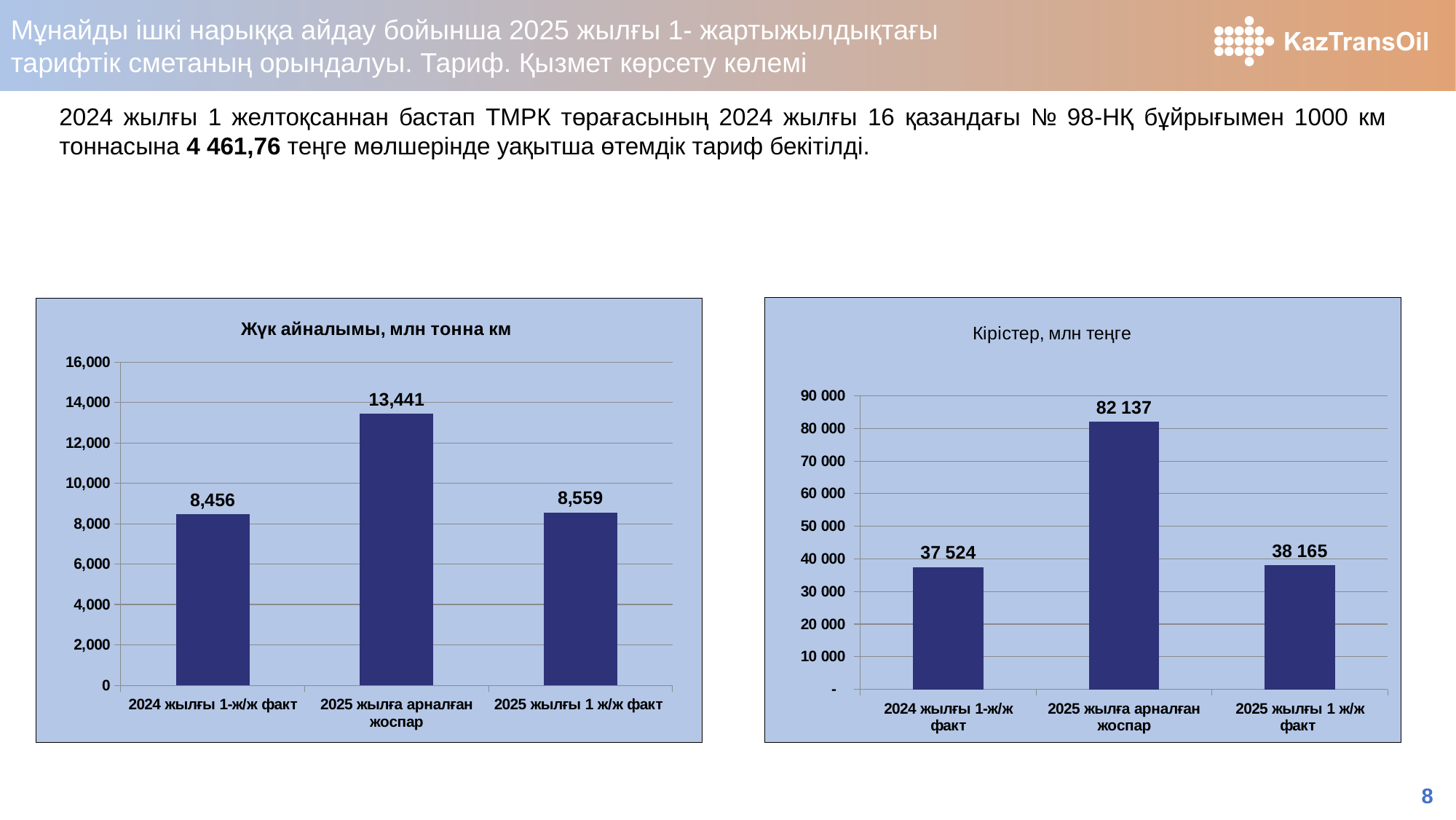
In the chart titled "Кірістер, млн теңге", is the value for "2025 жылға арналған жоспар" greater or less than 80 000? greater In the chart titled "Кірістер, млн теңге", what is the value for "2025 жылға арналған жоспар"? 82 137 What is the title of the chart on the left side of the slide? Жүк айналымы, млн тонна км In the chart titled "Жүк айналымы, млн тонна км", what is the value for "2025 жылға арналған жоспар"? 13,441 In the chart titled "Кірістер, млн теңге", what is the value for "2025 жылғы 1 ж/ж факт"? 38 165 What type of chart is the chart titled "Кірістер, млн теңге"? bar chart In the chart titled "Кірістер, млн теңге", which category has the highest value? 2025 жылға арналған жоспар In the chart titled "Кірістер, млн теңге", what is the difference between "2025 жылғы 1 ж/ж факт" and "2024 жылғы 1-ж/ж факт"? 641 In the chart titled "Жүк айналымы, млн тонна км", how many bars are plotted? 3 In the chart titled "Жүк айналымы, млн тонна км", which category has the lowest value? 2024 жылғы 1-ж/ж факт In the chart titled "Жүк айналымы, млн тонна км", what is the difference between "2025 жылға арналған жоспар" and "2025 жылғы 1 ж/ж факт"? 4,882 In the chart titled "Жүк айналымы, млн тонна км", what is the value for "2024 жылғы 1-ж/ж факт"? 8,456